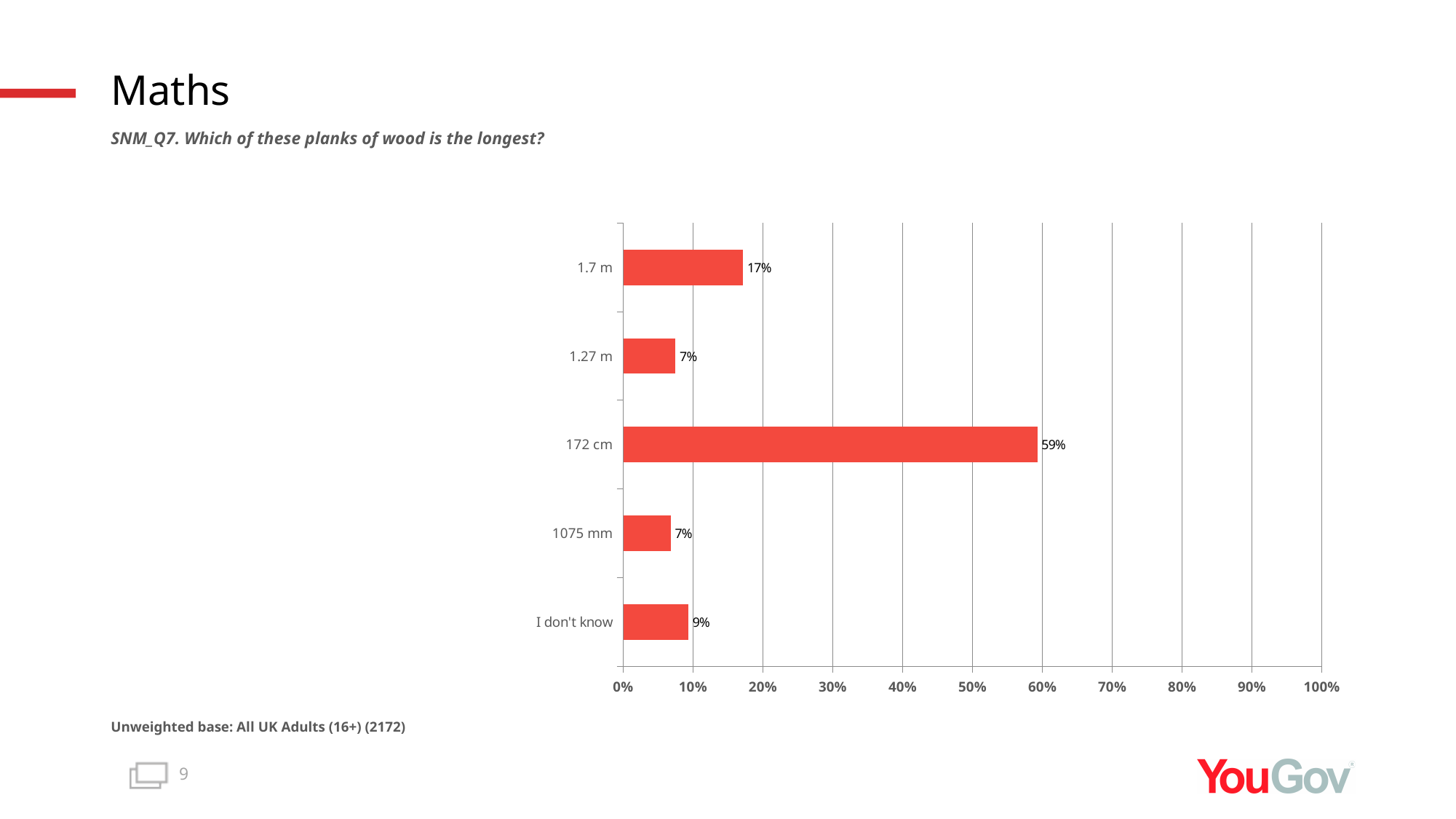
What percentage of respondents chose 172 cm? 59% Which has a larger percentage, 1.7 m or 'I don't know'? 1.7 m What percentage of respondents chose 1075 mm? 7% Is the value for 172 cm greater or less than 50%? greater What is the survey question shown above the chart? SNM_Q7. Which of these planks of wood is the longest? What percentage of respondents answered 'I don't know'? 9% What percentage of respondents chose 1.7 m? 17% What is the difference in percentage points between 172 cm and 1.7 m? 42 What type of chart is shown on the slide? bar chart What is the difference in percentage points between 1.7 m and 'I don't know'? 8 How many answer options are shown in the chart? 5 Which answer option has the highest percentage? 172 cm